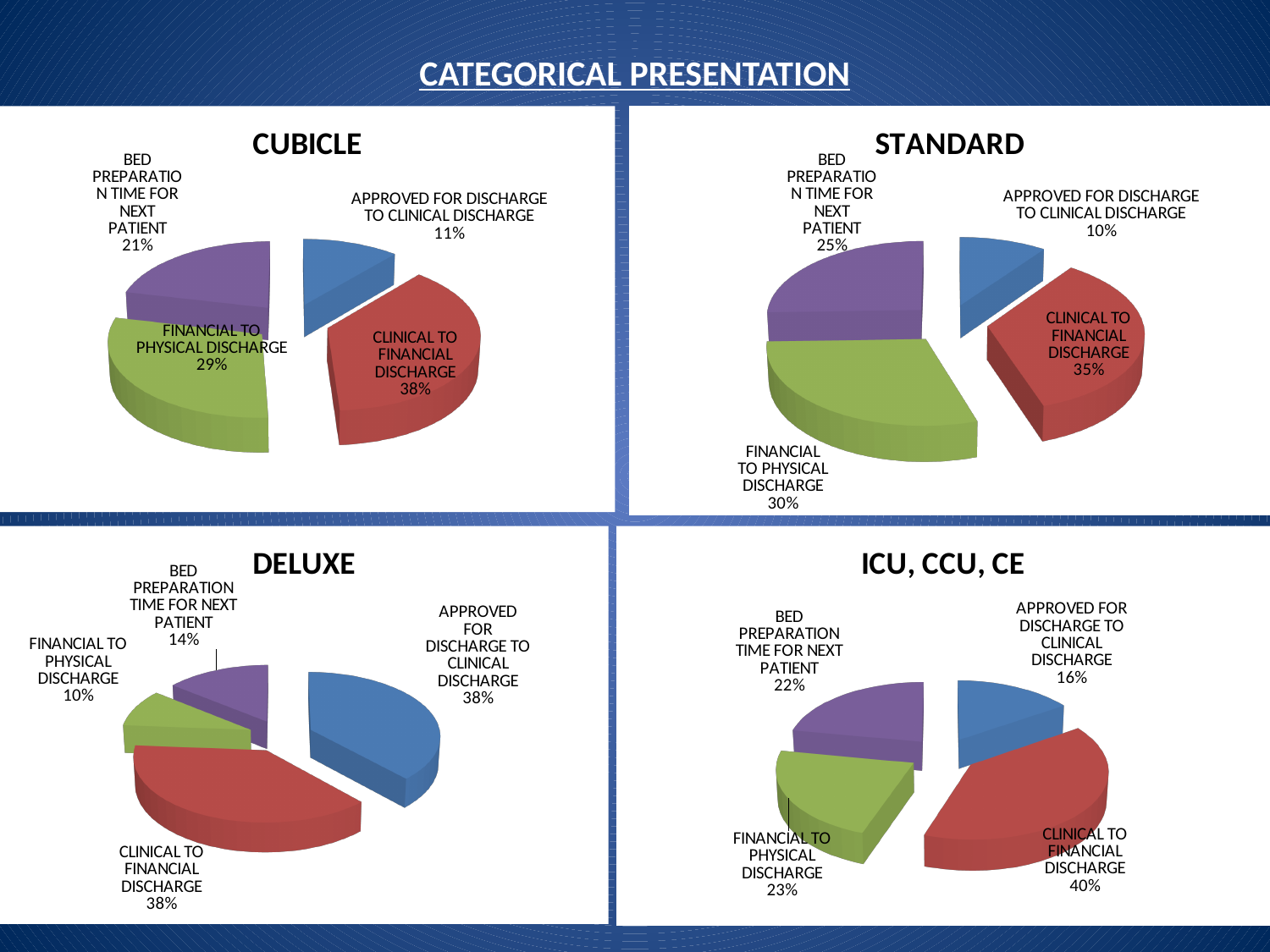
In the STANDARD chart, what share is labelled for BED PREPARATION TIME FOR NEXT PATIENT? 25% What kind of chart is the DELUXE chart? Pie chart In the ICU, CCU, CE chart, what is the difference in percentage points between CLINICAL TO FINANCIAL DISCHARGE and FINANCIAL TO PHYSICAL DISCHARGE? 17 percentage points What is the title of the chart in the bottom-right of the slide? ICU, CCU, CE In the ICU, CCU, CE chart, what share is labelled for APPROVED FOR DISCHARGE TO CLINICAL DISCHARGE? 16% In the DELUXE chart, which is larger: BED PREPARATION TIME FOR NEXT PATIENT or FINANCIAL TO PHYSICAL DISCHARGE? BED PREPARATION TIME FOR NEXT PATIENT How many slices does the STANDARD pie chart have? 4 In the DELUXE chart, what share is labelled for FINANCIAL TO PHYSICAL DISCHARGE? 10% In the CUBICLE chart, what share is labelled for CLINICAL TO FINANCIAL DISCHARGE? 38% In the CUBICLE chart, which category has the smallest share? APPROVED FOR DISCHARGE TO CLINICAL DISCHARGE In the STANDARD chart, which category has the largest share? CLINICAL TO FINANCIAL DISCHARGE How many charts are shown on the slide? 4